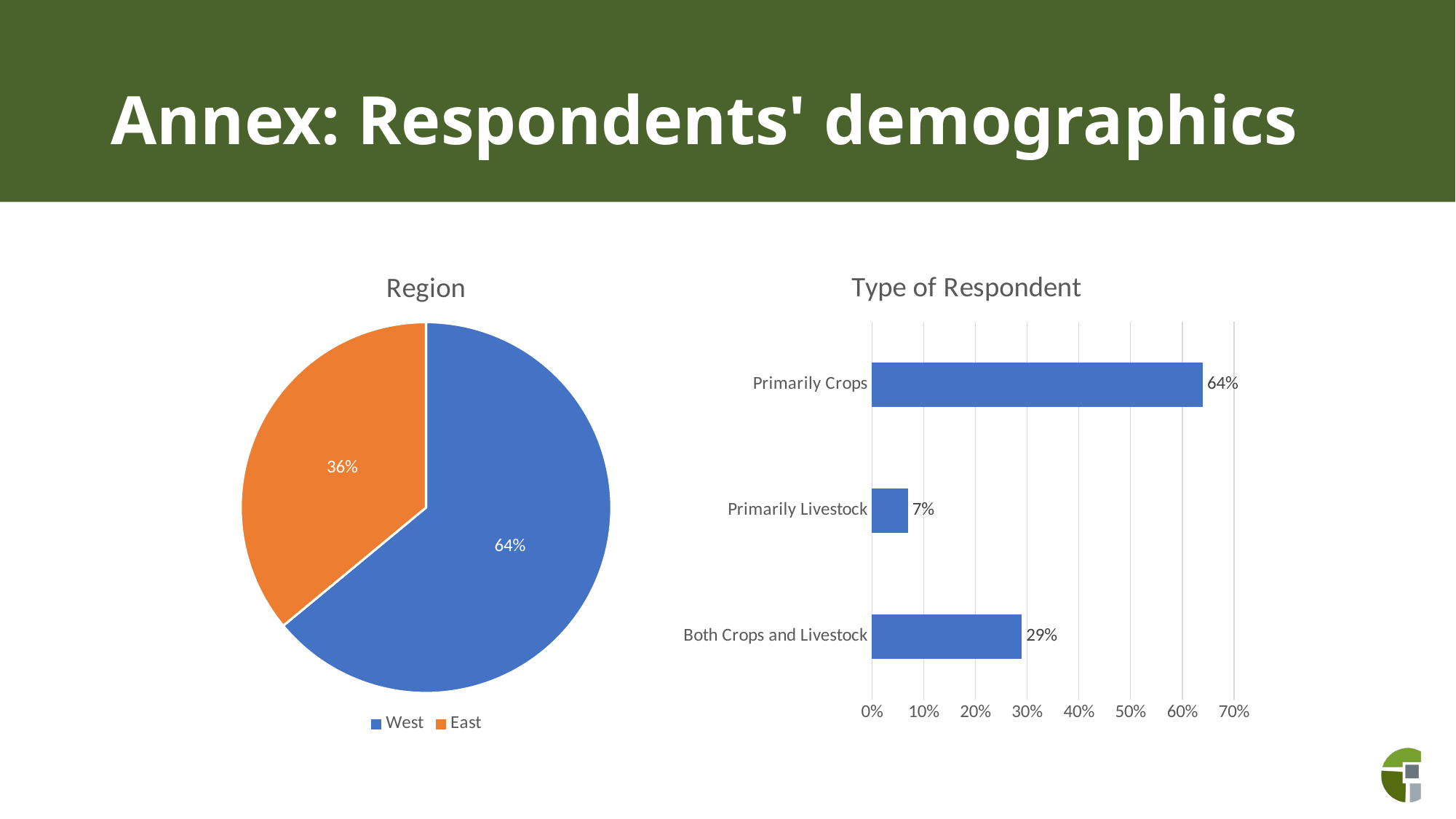
In the "Type of Respondent" chart, what is the difference between Primarily Crops and Both Crops and Livestock? 35% What kind of chart is the "Type of Respondent" chart? Bar chart In the "Type of Respondent" chart, what is the value for Primarily Crops? 64% In the "Type of Respondent" chart, which category has the lowest value? Primarily Livestock In the "Region" chart, what is the difference between the West and East shares? 28% What kind of chart is the "Region" chart? Pie chart In the "Type of Respondent" chart, what is the value for Both Crops and Livestock? 29% In the "Type of Respondent" chart, what is the value for Primarily Livestock? 7% In the "Region" chart, what share of respondents are from the East? 36% In the "Region" chart, which region has the larger share, West or East? West In the "Region" chart, what share of respondents are from the West? 64% In the "Region" chart, how many slices does the pie have? 2